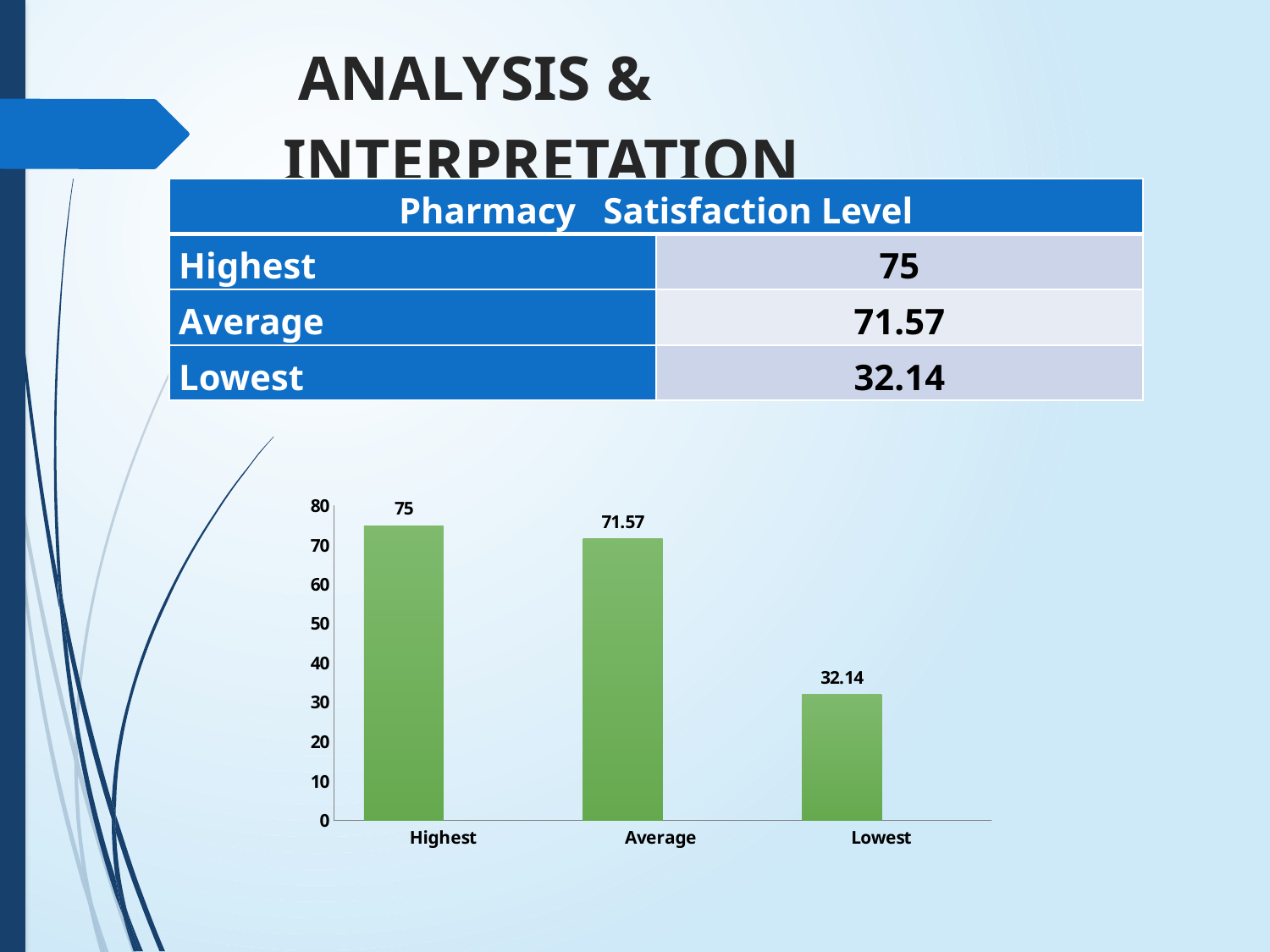
Which category has the highest value in the chart? Highest What is the value of the Average bar in the chart? 71.57 What is the difference between the Highest and Average values in the chart? 3.43 Is the value for Lowest greater or less than 40? less What is the value of the Lowest bar in the chart? 32.14 Which is larger in the chart, the Average value or the Lowest value? Average What kind of chart is shown on the slide? Bar chart What is the value of the Highest bar in the chart? 75 What is the difference between the Highest and Lowest values in the chart? 42.86 Which category has the lowest value in the chart? Lowest How many bars are shown in the chart? 3 What is the maximum value shown on the chart's vertical axis? 80